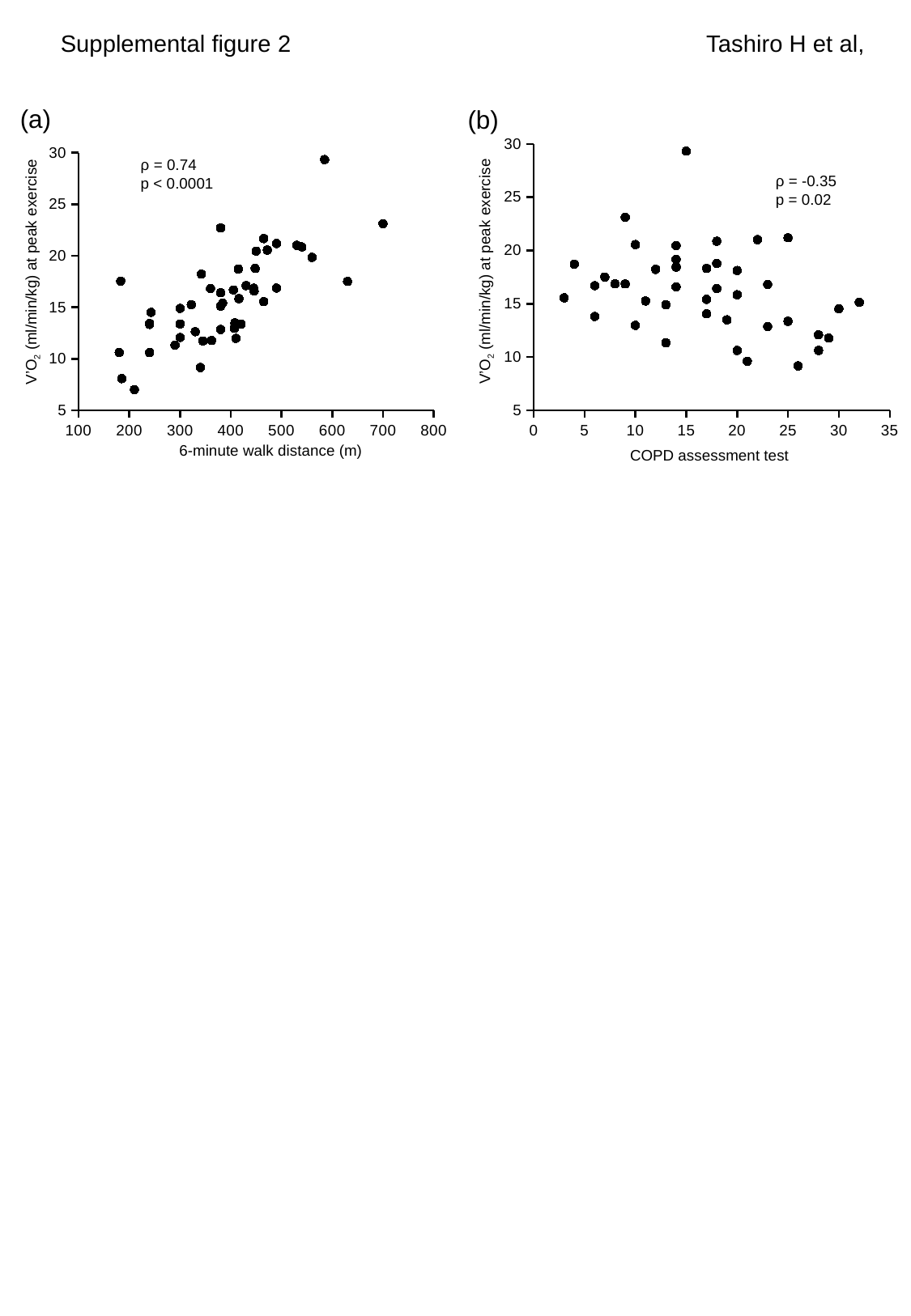
In chart (a), is the V'O2 value of the point at a 6-minute walk distance of 700 m greater or less than 20? greater What correlation coefficient ρ is shown on chart (b)? ρ = -0.35 In chart (b), do the V'O2 values generally rise or fall as the COPD assessment test score increases? Fall In chart (a), is the lowest plotted V'O2 value greater or less than 10? less In chart (b), is the highest plotted V'O2 value greater or less than 25? greater What kind of chart is chart (a)? Scatter plot In chart (a), do the V'O2 values generally rise or fall as 6-minute walk distance increases? Rise What correlation coefficient ρ is shown on chart (a)? ρ = 0.74 What kind of chart is chart (b)? Scatter plot